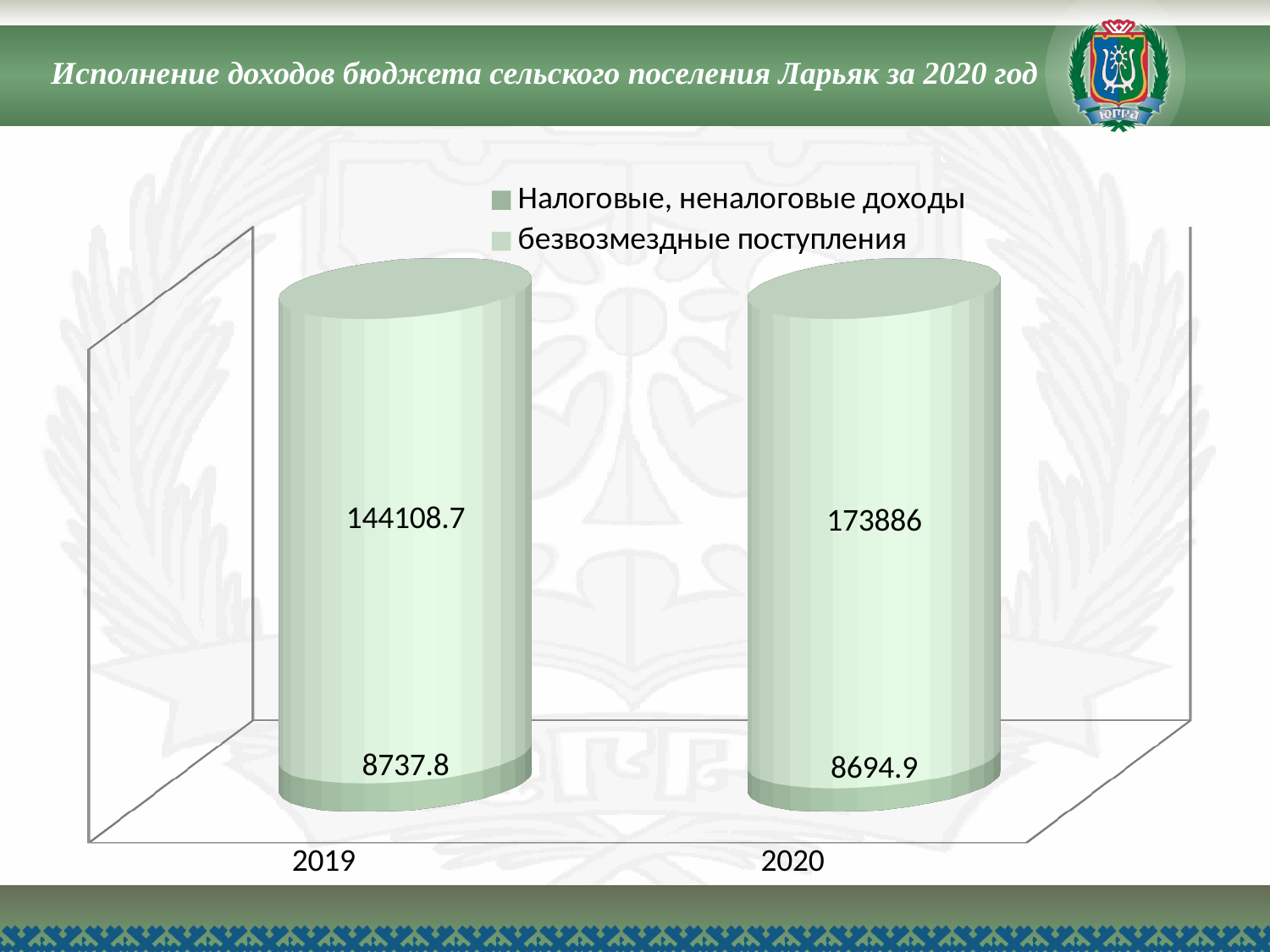
What is the value of Налоговые, неналоговые доходы for 2019? 8737.8 Which year has the higher value of безвозмездные поступления? 2020 What is the value of безвозмездные поступления for 2020? 173886 How many series does the legend list? 2 What is the total of the stacked bar for 2020? 182580.9 What is the difference between Налоговые, неналоговые доходы in 2019 and in 2020? 42.9 What is the difference between безвозмездные поступления in 2020 and in 2019? 29777.3 Which year has the lower value of Налоговые, неналоговые доходы? 2020 What is the total of the stacked bar for 2019? 152846.5 What is the value of безвозмездные поступления for 2019? 144108.7 What kind of chart is shown on the slide? Stacked bar chart What is the value of Налоговые, неналоговые доходы for 2020? 8694.9